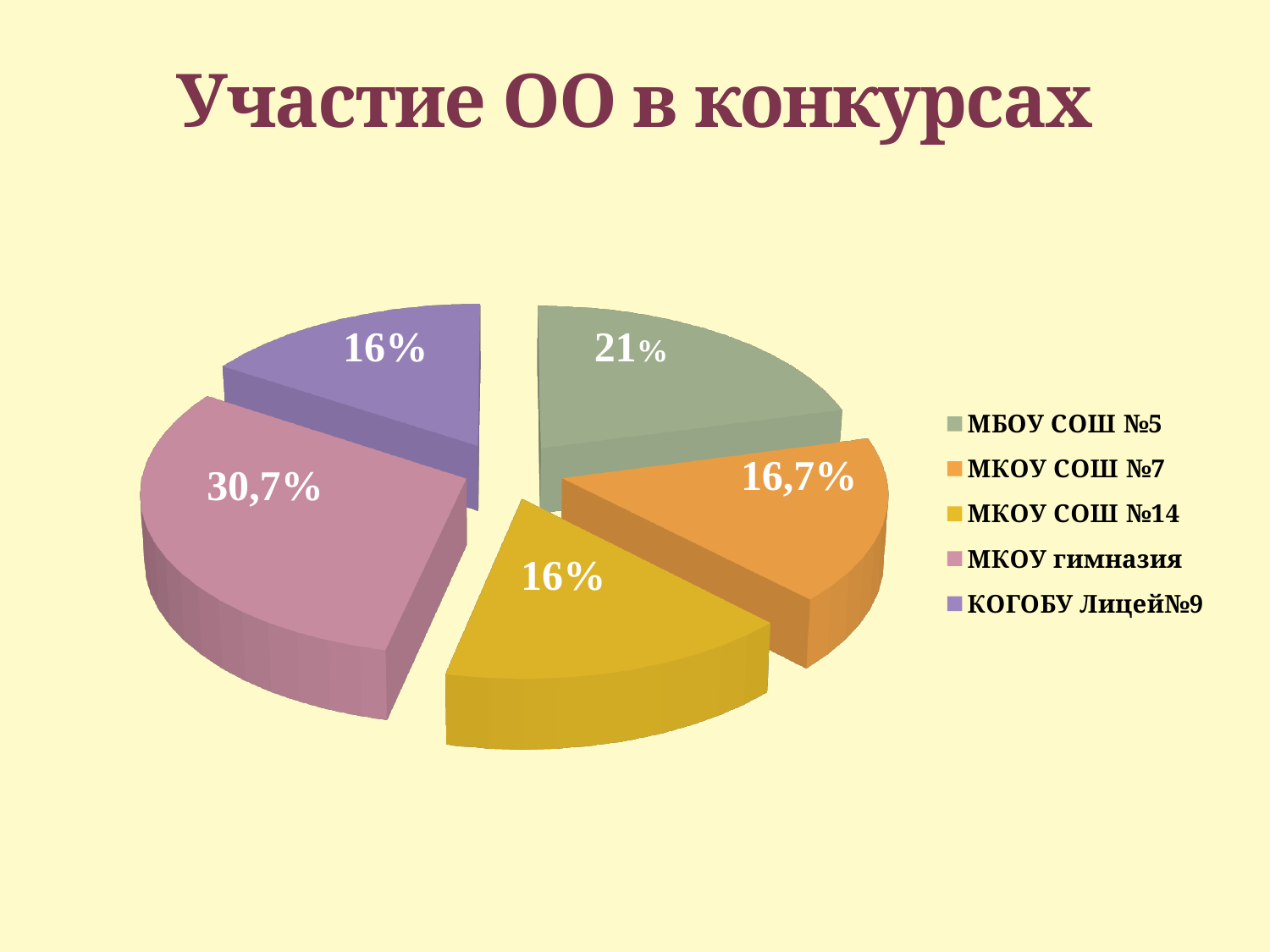
How many entries does the legend list? 5 How many slices does the pie chart have? 5 What kind of chart is shown on the slide? pie chart What share of the pie does МКОУ гимназия have? 30,7% What is the title of the slide above the chart? Участие ОО в конкурсах What is the value shown for КОГОБУ Лицей№9? 16% What is the value shown for МБОУ СОШ №5? 21% What is the difference between the values for МКОУ гимназия and МБОУ СОШ №5? 9,7% What is the value shown for МКОУ СОШ №14? 16% What is the value shown for МКОУ СОШ №7? 16,7% Which category has the largest slice of the pie? МКОУ гимназия Which is larger, the slice for МБОУ СОШ №5 or the slice for МКОУ СОШ №7? МБОУ СОШ №5